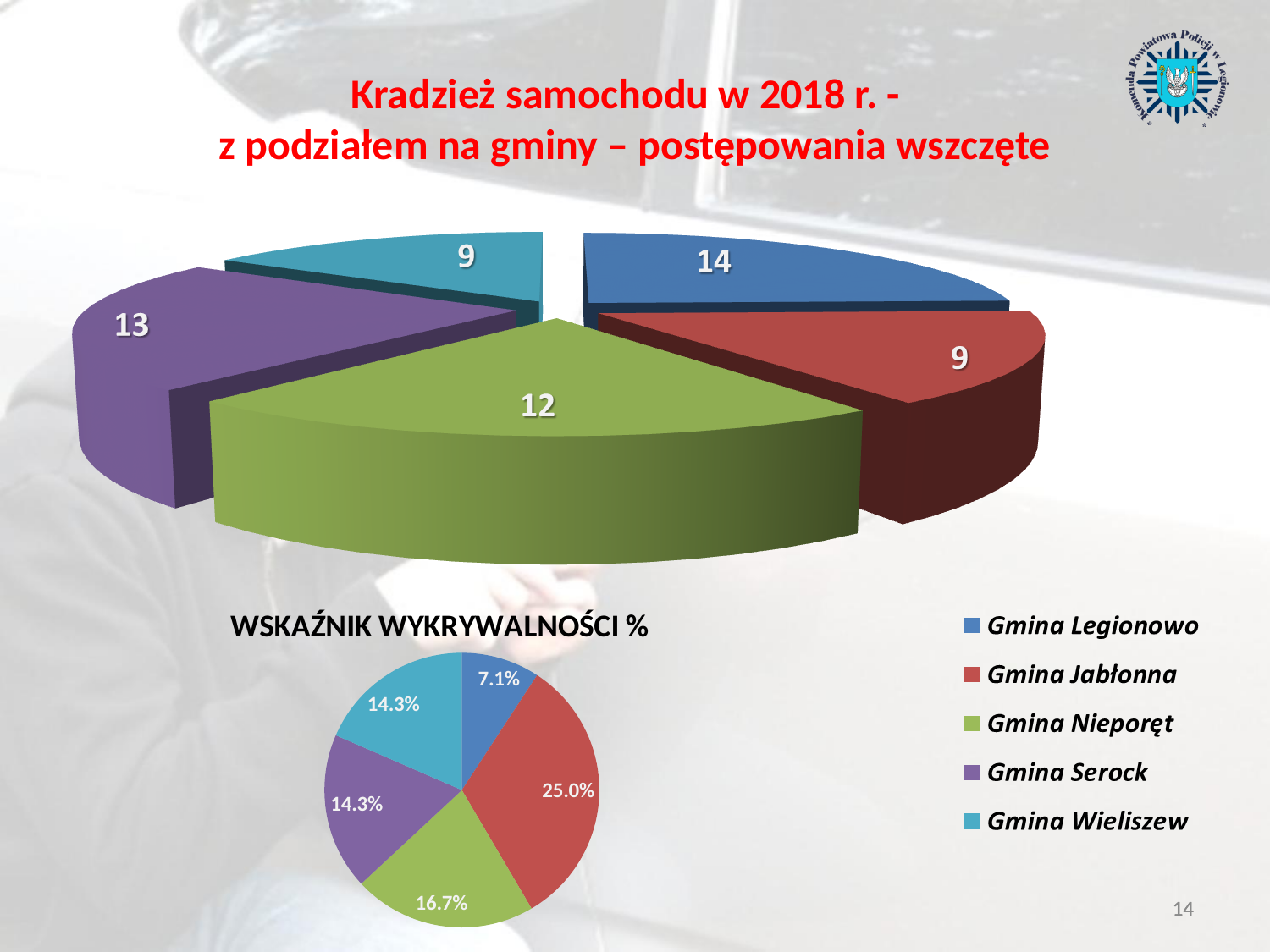
On the large pie chart, what is the value for Gmina Legionowo? 14 On the WSKAŹNIK WYKRYWALNOŚCI % chart, which gmina has the lowest value? Gmina Legionowo On the large pie chart, what is the value for Gmina Nieporęt? 12 On the large pie chart, which is larger: the value for Gmina Serock or Gmina Nieporęt? Gmina Serock On the large pie chart, which gmina has the highest value? Gmina Legionowo On the large pie chart, what is the total of all slice values? 57 What type of chart is the WSKAŹNIK WYKRYWALNOŚCI % chart? Pie chart On the large pie chart, how many slices are there? 5 On the large pie chart, what is the value for Gmina Serock? 13 On the large pie chart, what is the difference between the values for Gmina Legionowo and Gmina Jabłonna? 5 On the WSKAŹNIK WYKRYWALNOŚCI % chart, what is the value for Gmina Nieporęt? 16.7% On the WSKAŹNIK WYKRYWALNOŚCI % chart, what is the value for Gmina Jabłonna? 25.0%